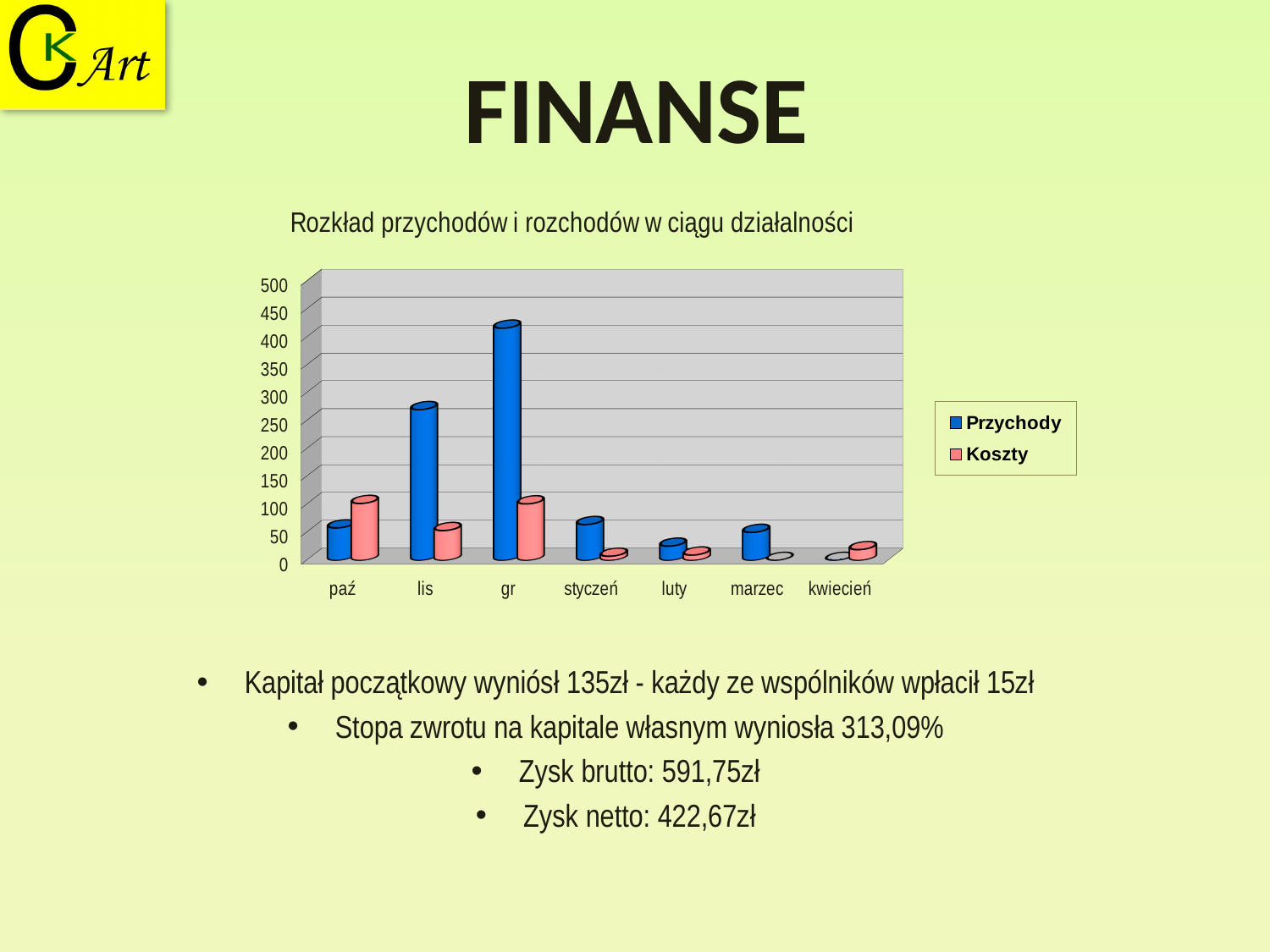
What kind of chart is shown on the slide? bar chart How many categories are shown on the x axis? 7 Which category has the lowest Przychody value? kwiecień How many series does the legend list? 2 Which colour represents the Koszty series? pink Which category has the highest Przychody value? gr For lis, which is larger: Przychody or Koszty? Przychody Is the Przychody value for gr greater or less than 350? greater What is the title of the chart? Rozkład przychodów i rozchodów w ciągu działalności Is the Przychody value for luty greater or less than 100? less For paź, which is larger: Przychody or Koszty? Koszty Is the Przychody value for lis greater or less than 200? greater